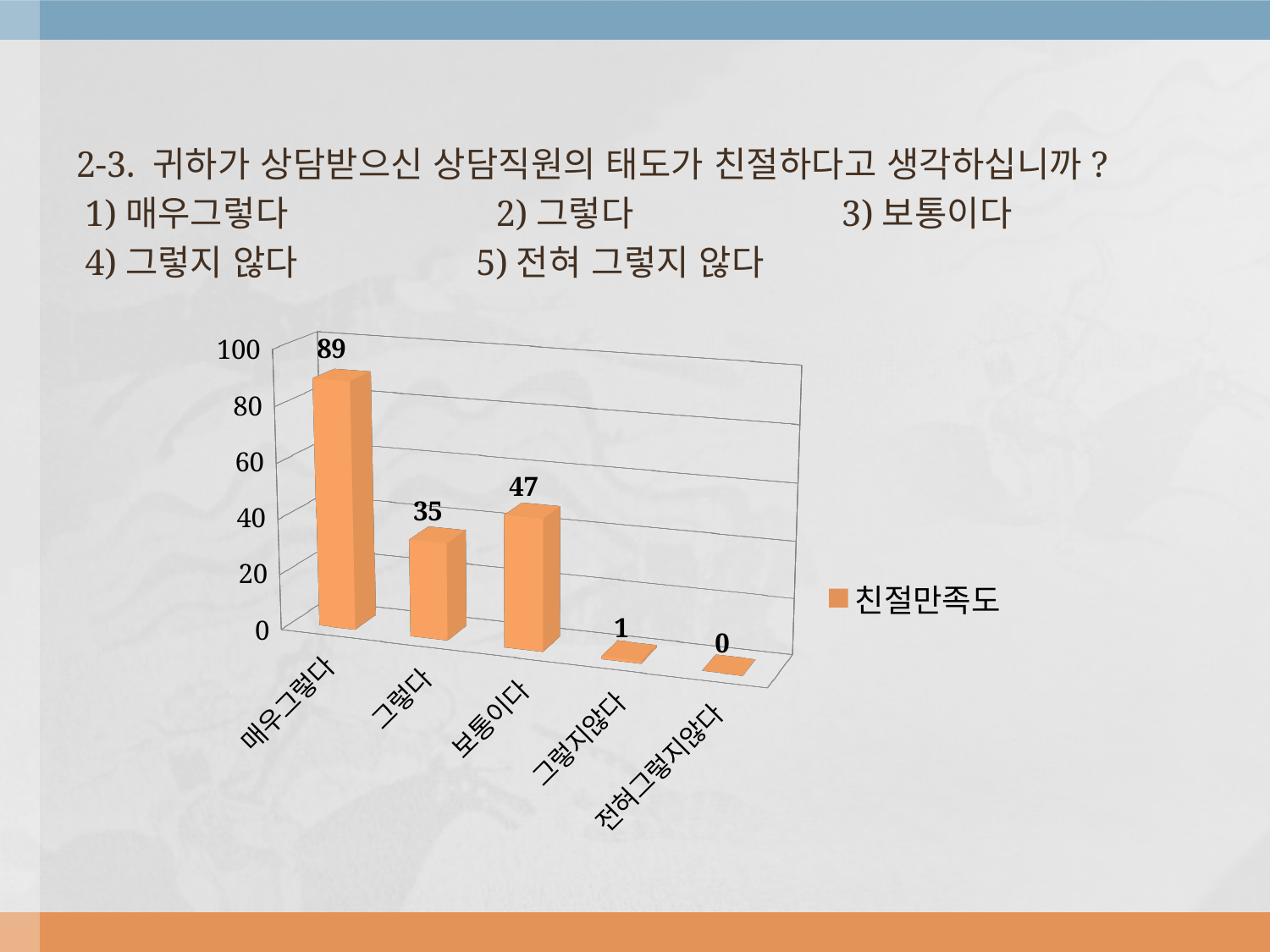
What is the value for 그렇지않다? 1 What is the value for 매우그렇다? 89 Is the value for 그렇다 greater or less than 40? less How many series does the legend list? 1 What kind of chart is shown? bar chart What is the legend entry for the series? 친절만족도 What is the difference between the values for 매우그렇다 and 보통이다? 42 What is the value for 보통이다? 47 Which is larger, the value for 그렇다 or the value for 보통이다? 보통이다 How many categories are shown on the x axis? 5 Which category has the highest value? 매우그렇다 Which category has the lowest value? 전혀그렇지않다